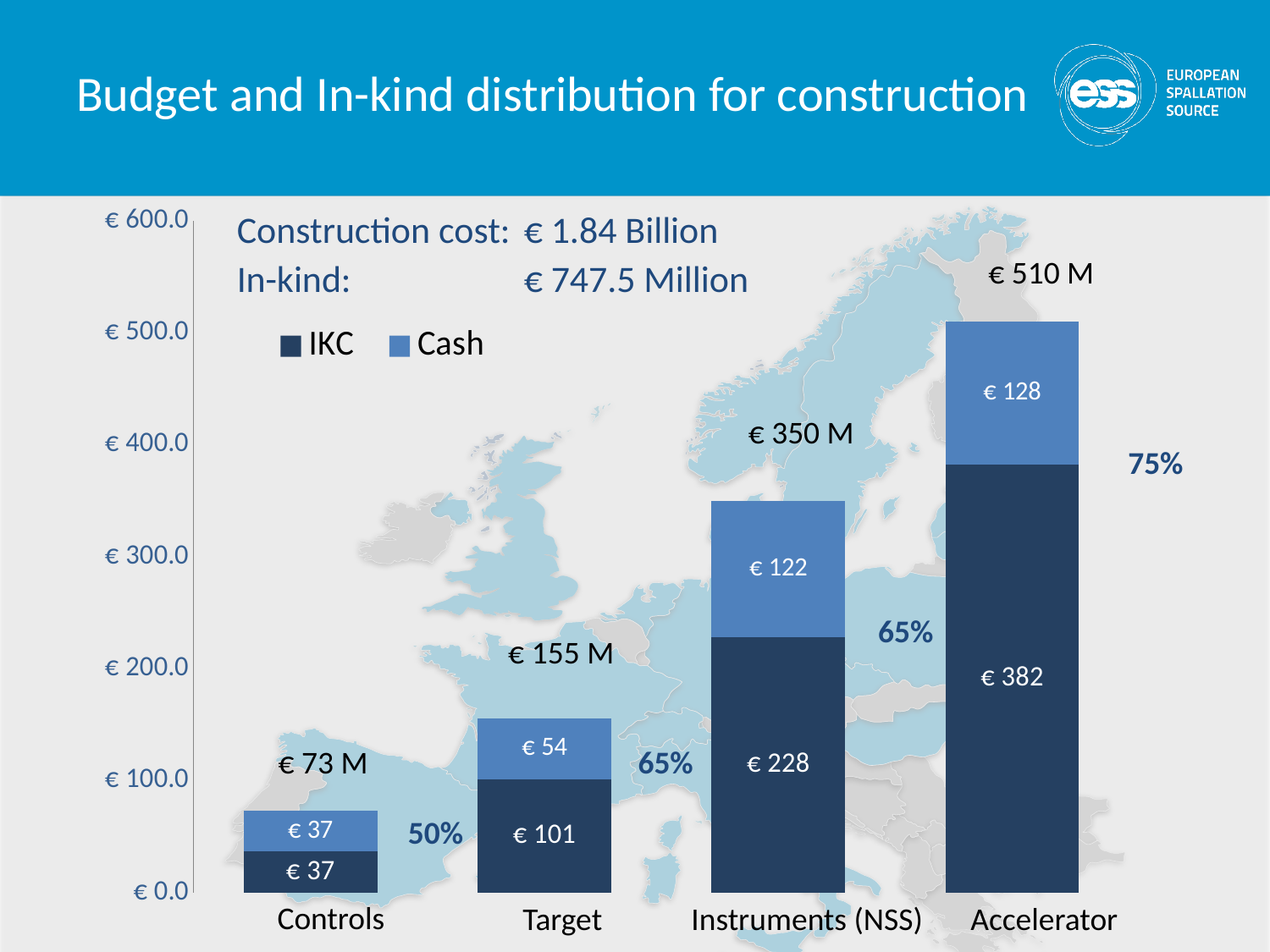
Which category has the lowest total bar? Controls What is the difference between the IKC values for Accelerator and Instruments (NSS)? € 154 What is the total of the stacked bar for Instruments (NSS)? € 350 M What is the Cash value for Target? € 54 Which is larger, the IKC value for Target or the Cash value for Accelerator? Cash value for Accelerator What is the IKC value for Accelerator? € 382 What percentage is shown next to the Controls bar? 50% How many categories are shown on the x axis? 4 What kind of chart is shown on the slide? Stacked bar chart How many series does the legend list? 2 What is the Cash value for Instruments (NSS)? € 122 Which category has the highest total bar? Accelerator